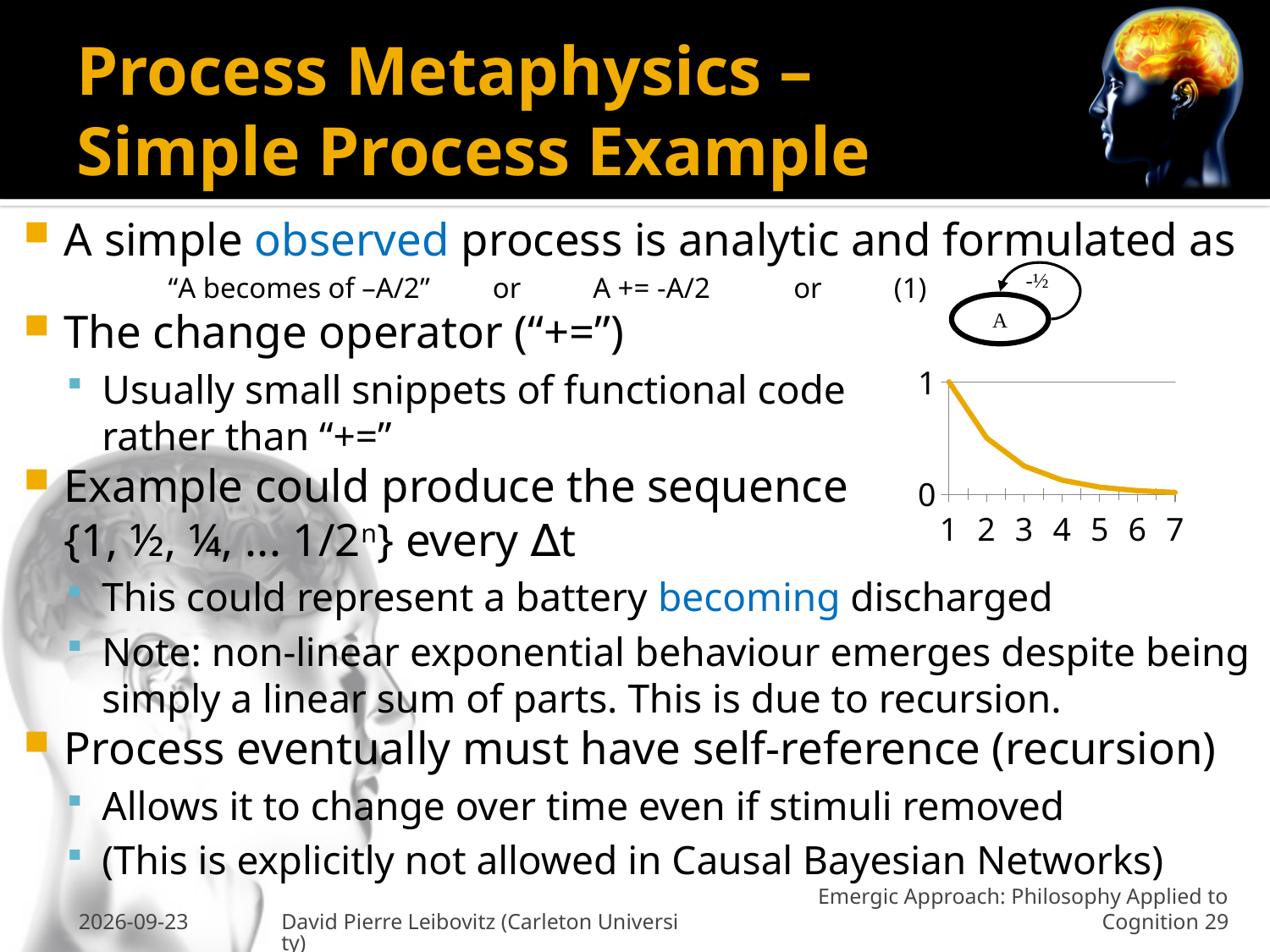
What is the value plotted at x = 1 in the chart? 1 At which x value is the plotted value highest? 1 Which is larger, the value at x = 2 or the value at x = 5? x = 2 Is the value at x = 7 greater or less than 1? less Do the values in the chart rise or fall as x increases from 1 to 7? fall What is the highest tick label shown on the y axis of the chart? 1 What kind of chart is shown on the slide? line chart What colour is the line in the chart? orange How many points are plotted along the x axis of the chart? 7 Is the value at x = 2 greater or less than 1? less Which is larger, the value at x = 1 or the value at x = 3? x = 1